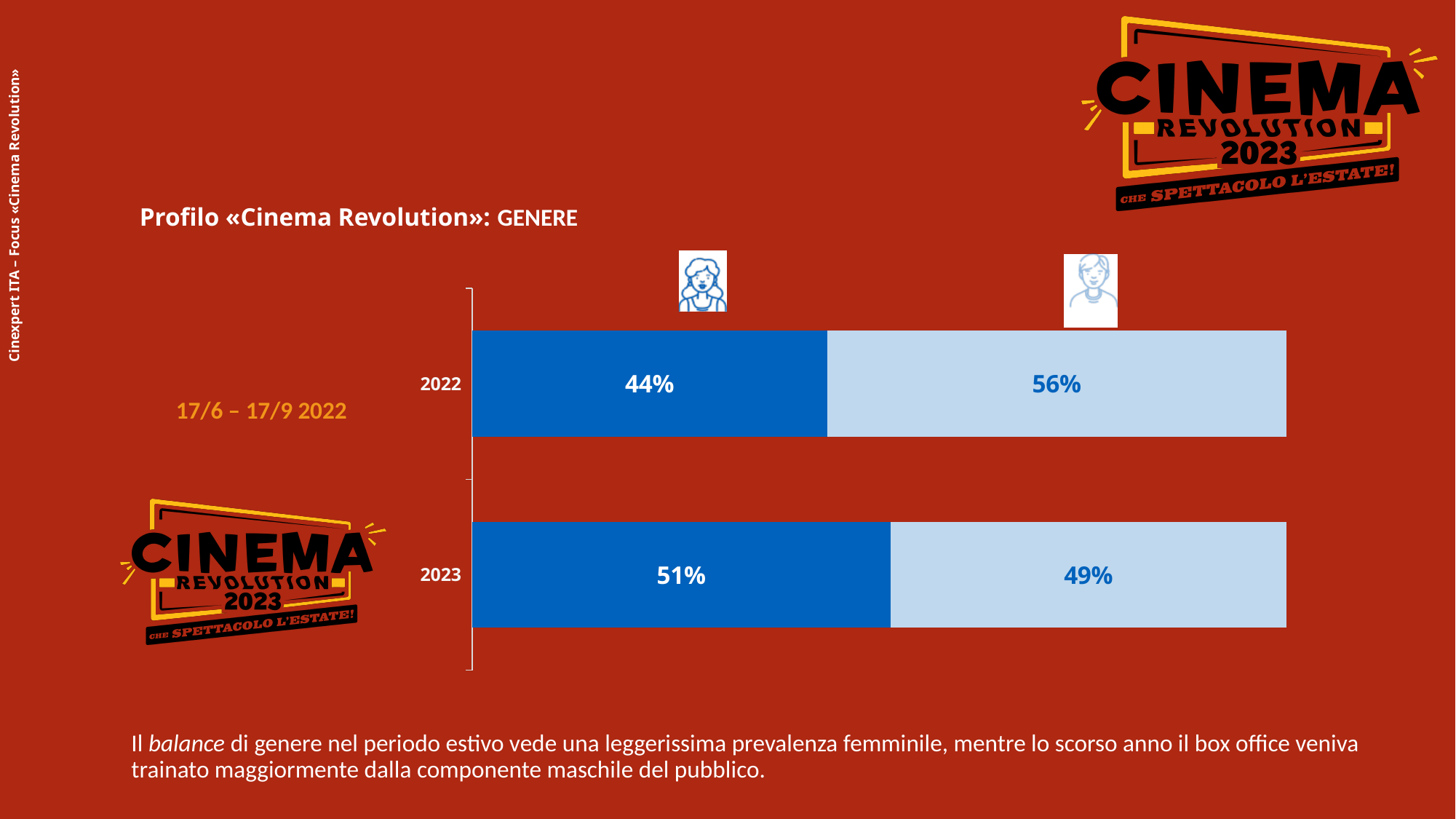
How many years (bars) are shown in the chart? 2 What is the female share (dark blue segment) for 2023? 51% What kind of chart is shown on the slide? stacked bar chart What is the difference between the male and female shares in 2022? 12 percentage points In 2022, which segment is larger, the female (dark blue) or the male (light blue)? male (light blue) By how many percentage points did the female share increase from 2022 to 2023? 7 percentage points In 2023, which segment is larger, the female (dark blue) or the male (light blue)? female (dark blue) What is the male share (light blue segment) for 2023? 49% What is the male share (light blue segment) for 2022? 56% What is the female share (dark blue segment) for 2022? 44% What is the title of the chart? Profilo «Cinema Revolution»: GENERE What is the total of the two segments in the 2023 bar? 100%